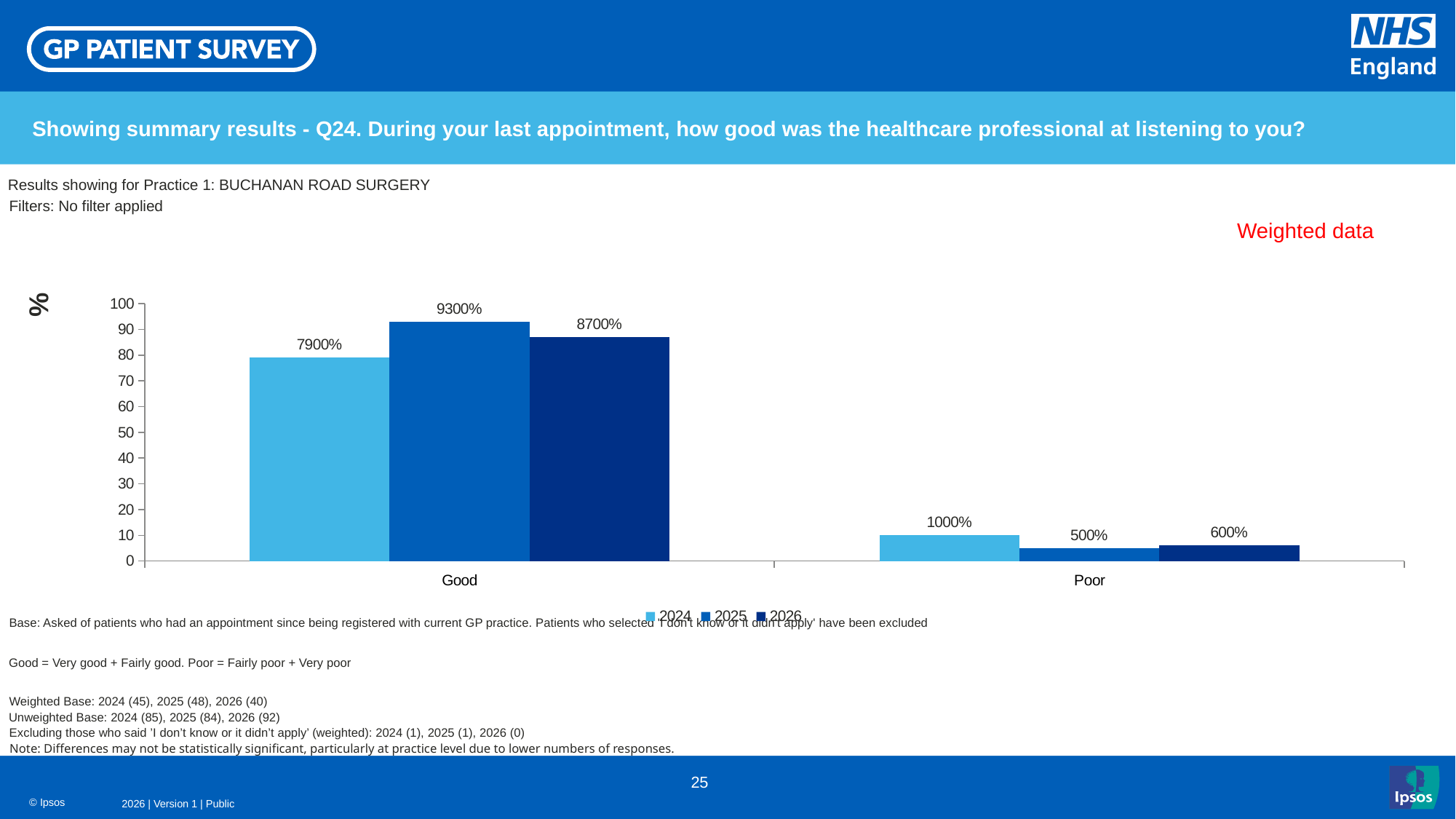
What is the data label for the 2025 series in the Good category? 9300% Which year has the lowest bar in the Poor category? 2025 How many categories are shown on the x axis? 2 What kind of chart is shown on the slide? Bar chart What are the entries in the chart legend? 2024, 2025, 2026 In the Poor category, is the 2024 bar or the 2026 bar larger? 2024 What is the data label for the 2024 series in the Poor category? 1000% Which year has the highest bar in the Good category? 2025 How many series does the legend list? 3 What is the data label for the 2024 series in the Good category? 7900% What is the difference between the 2025 and 2024 data labels in the Good category? 1400% What is the data label for the 2026 series in the Poor category? 600%